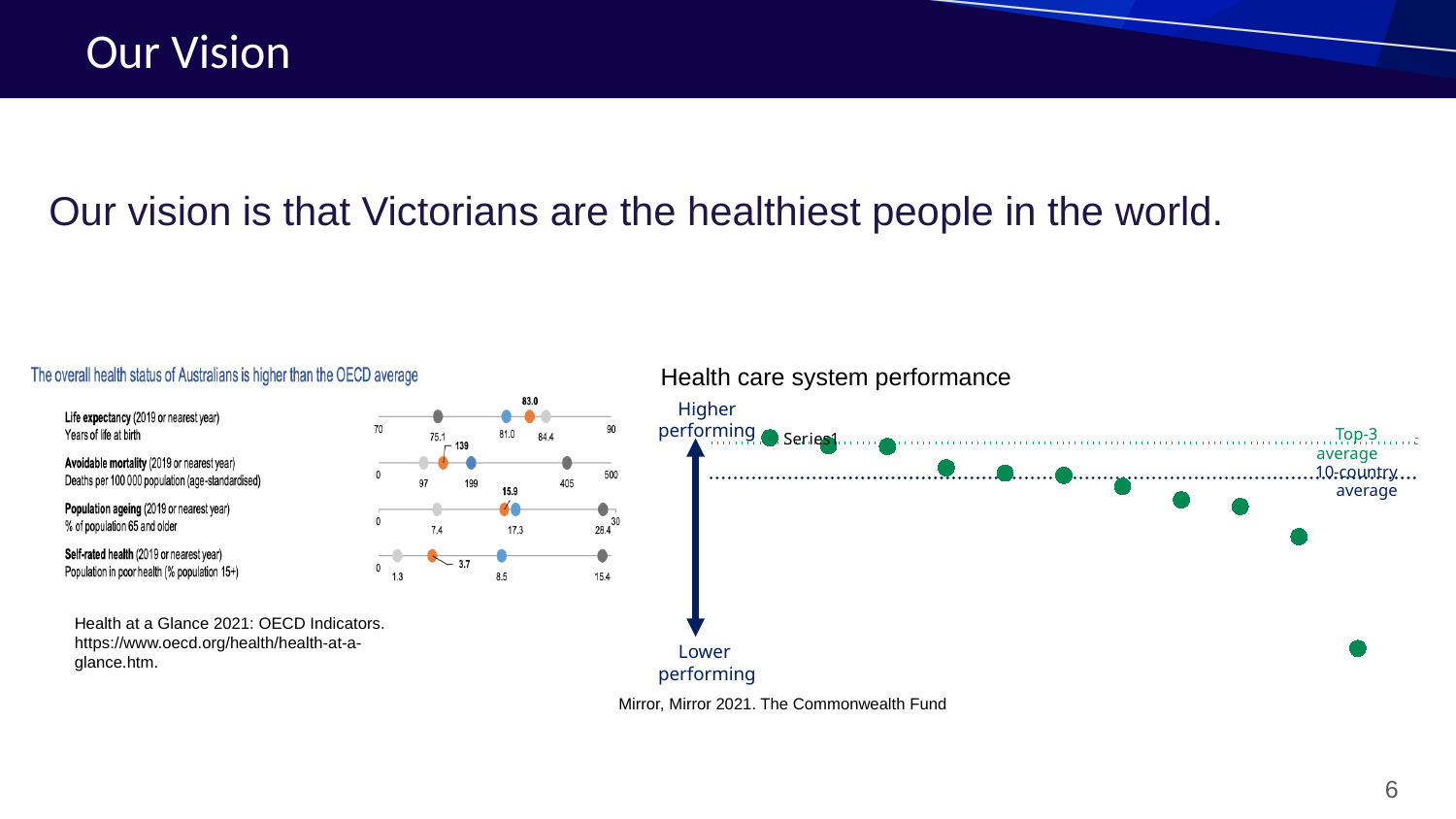
What are the two dotted reference lines labelled in the 'Health care system performance' chart? Top-3 average and 10-country average How many series does the legend of the 'Health care system performance' chart list? 1 In the left chart on Australian health status, what is the bold value printed on the Life expectancy row? 83.0 What is the legend entry shown in the 'Health care system performance' chart? Series1 In the left chart on Australian health status, which is larger on the Self-rated health row: the bold value 3.7 or the value 8.5? 8.5 In the 'Health care system performance' chart, do the plotted points rise or fall from left to right? fall How many data points are plotted in the 'Health care system performance' chart on the right? 11 In the left chart on Australian health status, what is the bold value printed on the Population ageing row? 15.9 In the left chart on Australian health status, what is the difference between the highest (84.4) and lowest (75.1) values on the Life expectancy row? 9.3 What kind of chart is the 'Health care system performance' chart on the right? scatter chart